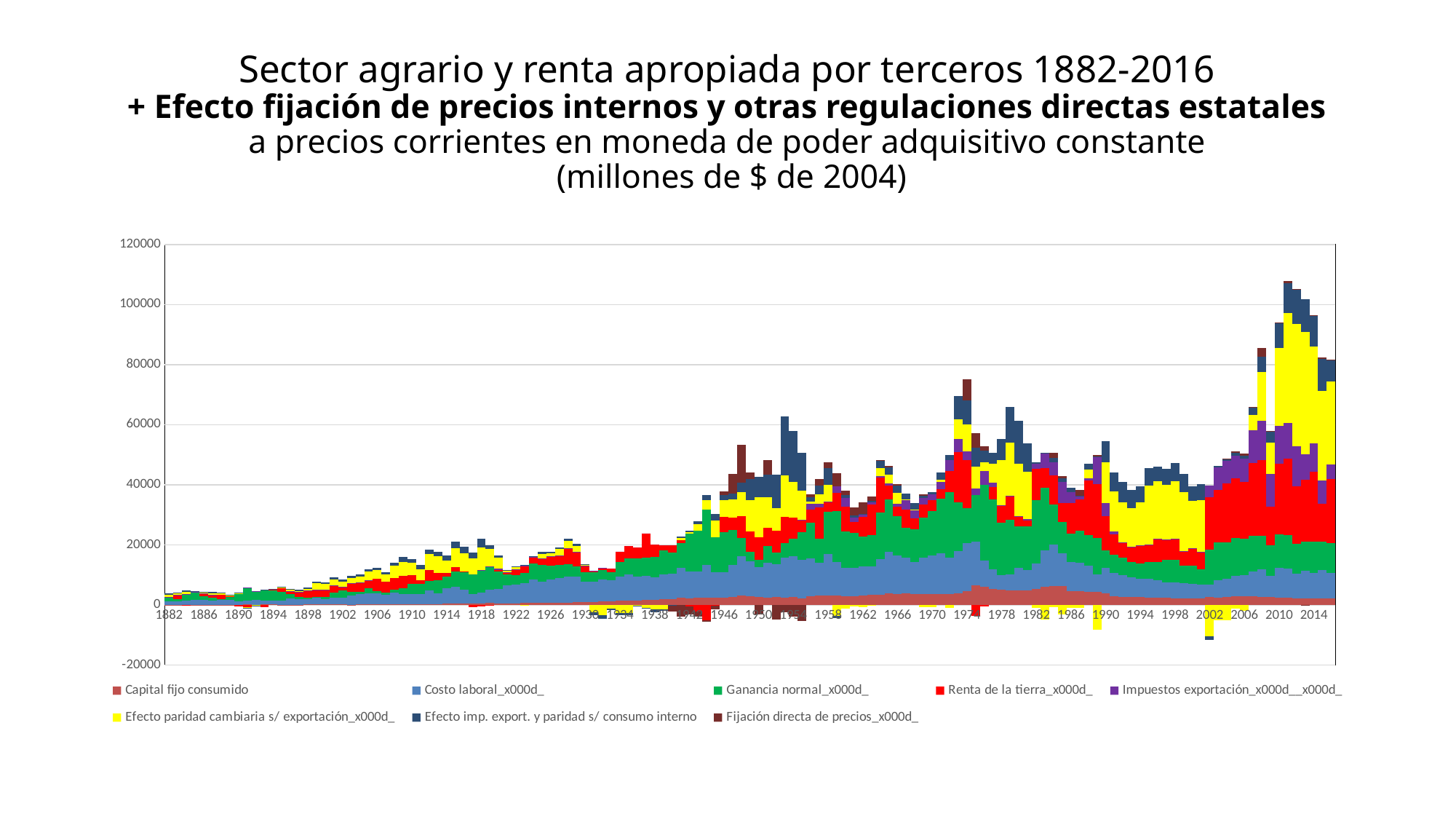
What kind of chart is shown on the slide? Stacked bar chart Which series is shown in yellow in the legend? Efecto paridad cambiaria s/ exportación Is the stacked total for 2010 greater or less than 80000? greater How many series does the legend list? 8 Do the stacked totals generally rise or fall from 1882 to 2016? rise Is the stacked total for 1882 greater or less than 20000? less What is the highest value shown on the vertical axis? 120000 Is the highest stacked total on the chart greater or less than 100000? greater What is the unit stated in the chart title? millones de $ de 2004